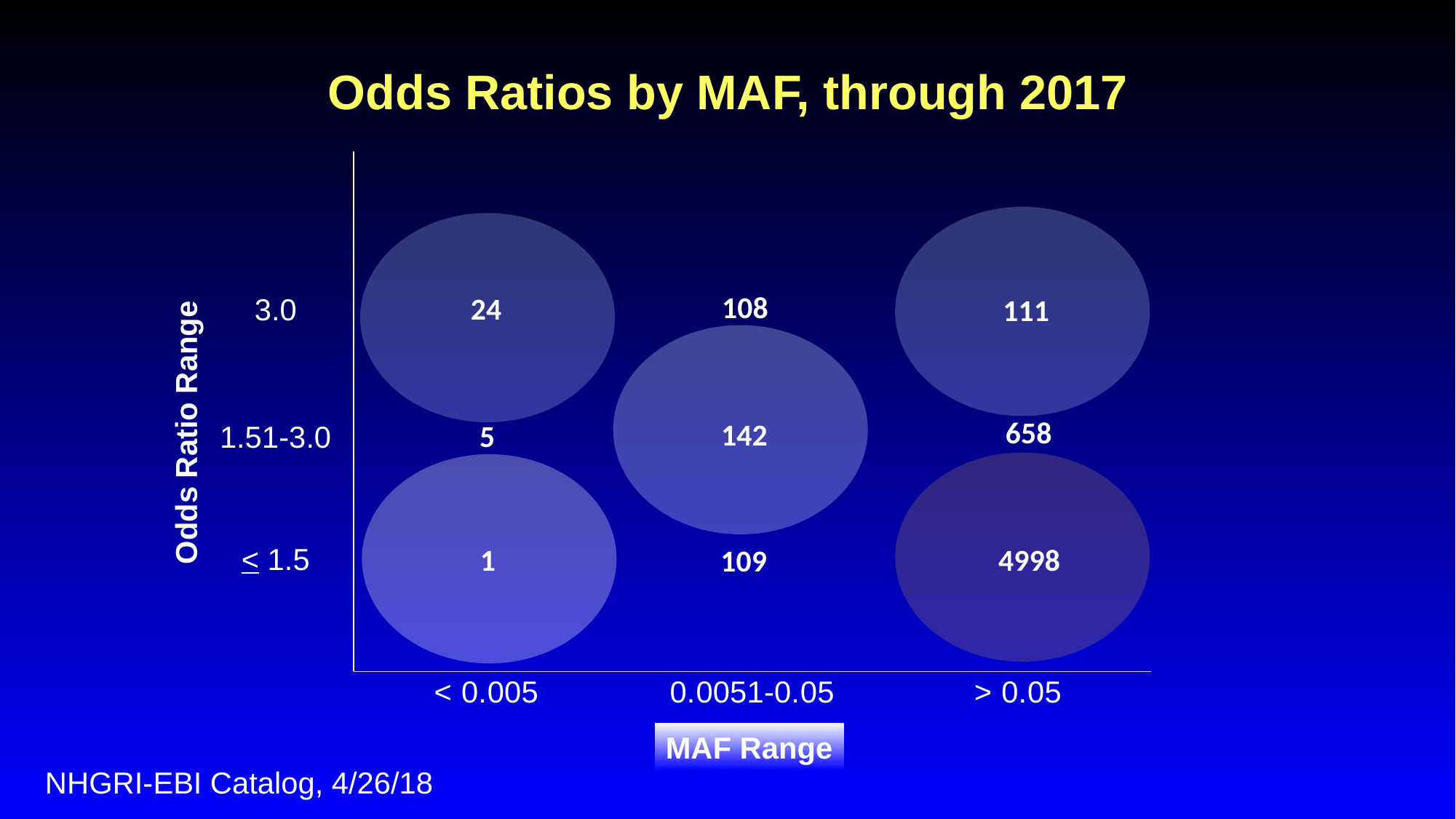
How many odds ratio range categories are shown on the y axis? 3 Which is larger: the value for MAF 0.0051-0.05 at odds ratio 3.0, or the value for MAF 0.0051-0.05 at odds ratio ≤ 1.5? MAF 0.0051-0.05 at odds ratio ≤ 1.5 (109) What is the value for MAF range < 0.005 and odds ratio range 3.0? 24 Which cell in the grid has the lowest value? MAF < 0.005, odds ratio ≤ 1.5 (1) What is the difference between the values for MAF > 0.05 and MAF 0.0051-0.05 in the odds ratio range 1.51-3.0? 516 What is the value for MAF range 0.0051-0.05 and odds ratio range 1.51-3.0? 142 How many MAF range categories are shown on the x axis? 3 What is the label of the y axis? Odds Ratio Range What is the value for MAF range > 0.05 and odds ratio range ≤ 1.5? 4998 Which cell in the grid has the highest value? MAF > 0.05, odds ratio ≤ 1.5 (4998) What is the title of the chart? Odds Ratios by MAF, through 2017 What is the value for MAF range > 0.05 and odds ratio range 1.51-3.0? 658